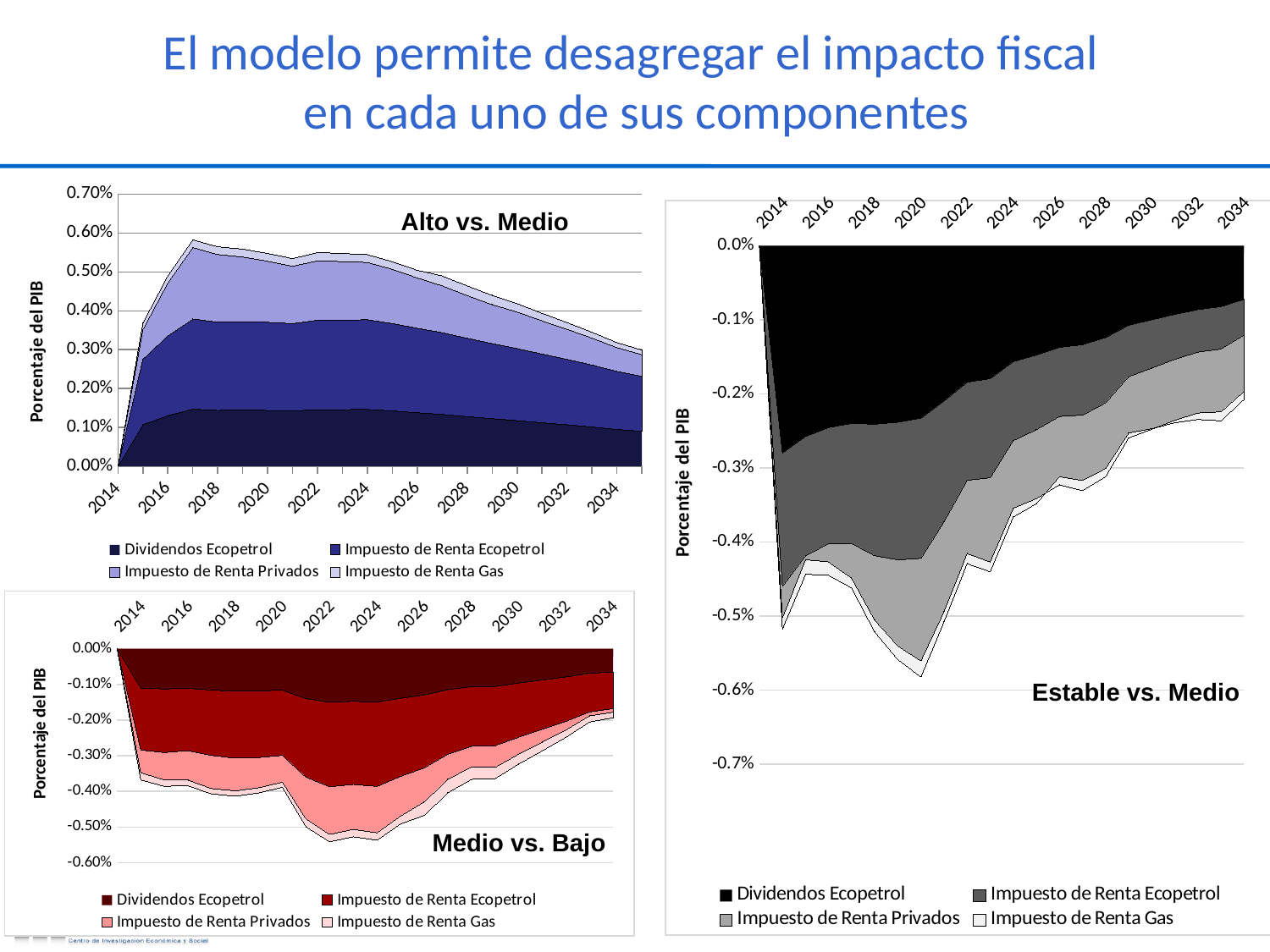
In the 'Alto vs. Medio' chart, is the total stacked value in 2018 greater or less than 0.50%? greater In the 'Alto vs. Medio' chart, does the total stacked value rise or fall from 2024 to 2034? fall What kind of chart is the 'Alto vs. Medio' chart? stacked area chart What is the y-axis label of the 'Estable vs. Medio' chart? Porcentaje del PIB In the 'Medio vs. Bajo' chart, is the total stacked value in 2034 greater or less than -0.30%? greater In the 'Estable vs. Medio' chart, is the total stacked value in 2020 greater or less than -0.50%? less In the 'Estable vs. Medio' chart, does the total stacked value rise or fall from 2020 to 2034? rise In the 'Estable vs. Medio' chart, which series is shown in black? Dividendos Ecopetrol How many year labels are shown on the x axis of the 'Medio vs. Bajo' chart? 11 How many series does the legend of the 'Estable vs. Medio' chart list? 4 How many series does the legend of the 'Alto vs. Medio' chart list? 4